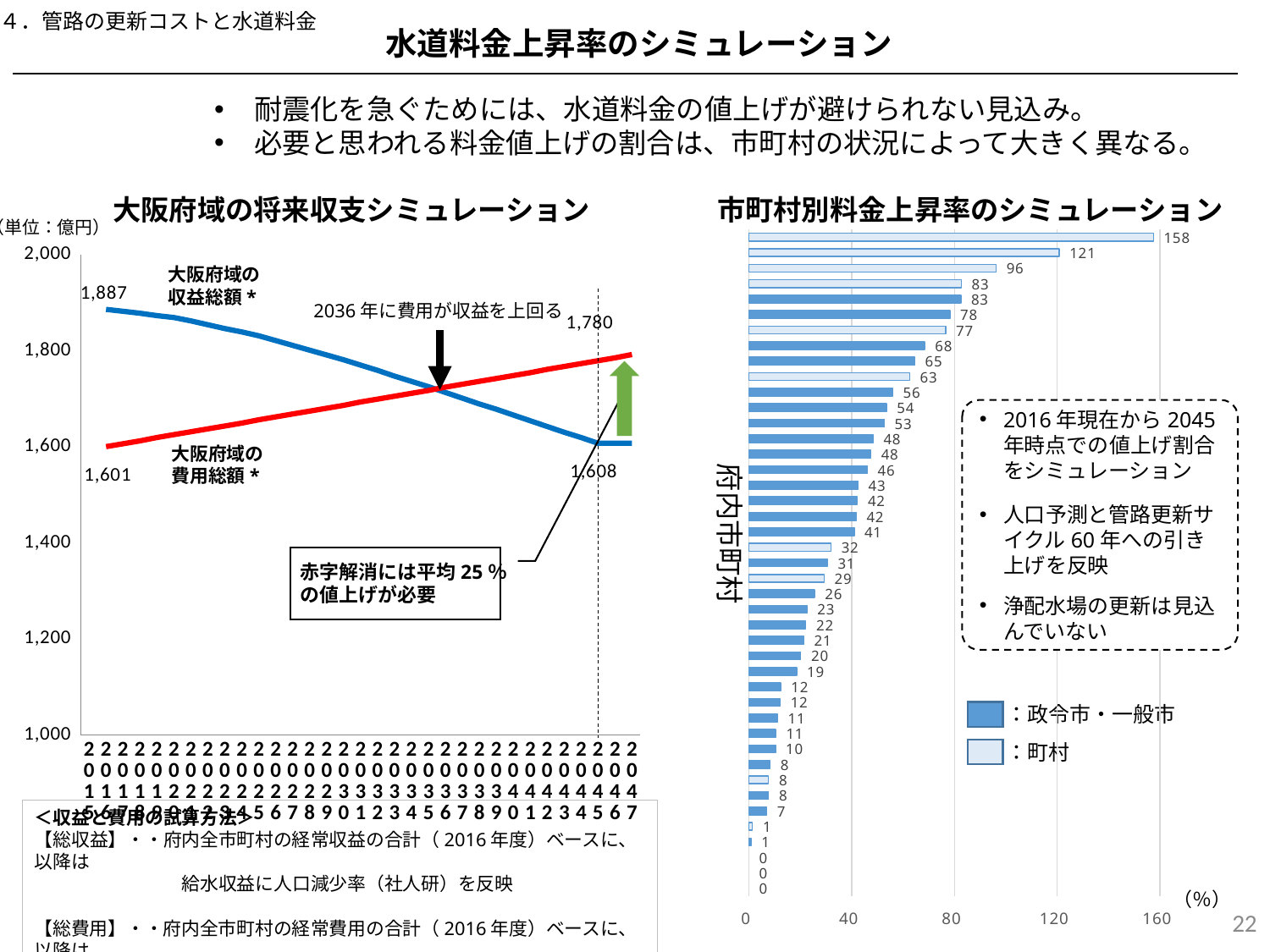
In the right chart 市町村別料金上昇率のシミュレーション, what unit is shown on the horizontal axis? % What kind of chart is the right chart titled 市町村別料金上昇率のシミュレーション? bar chart In the right chart 市町村別料金上昇率のシミュレーション, what is the difference between the two largest values, 158 and 121? 37 In the left chart 大阪府域の将来収支シミュレーション, in which year does the annotation say costs exceed revenue? 2036 What kind of chart is the left chart titled 大阪府域の将来収支シミュレーション? line chart In the left chart 大阪府域の将来収支シミュレーション, what is the value of 大阪府域の収益総額 at the end of the series? 1,608 In the left chart 大阪府域の将来収支シミュレーション, what is the starting value of 大阪府域の収益総額 in 2016? 1,887 In the left chart 大阪府域の将来収支シミュレーション, does 大阪府域の費用総額 rise or fall over the years? rise In the right chart 市町村別料金上昇率のシミュレーション, how many series does the legend list? 2 In the right chart 市町村別料金上昇率のシミュレーション, what is the highest value shown? 158 In the left chart 大阪府域の将来収支シミュレーション, by how much does 大阪府域の収益総額 fall from its starting value 1,887 to its ending value 1,608? 279